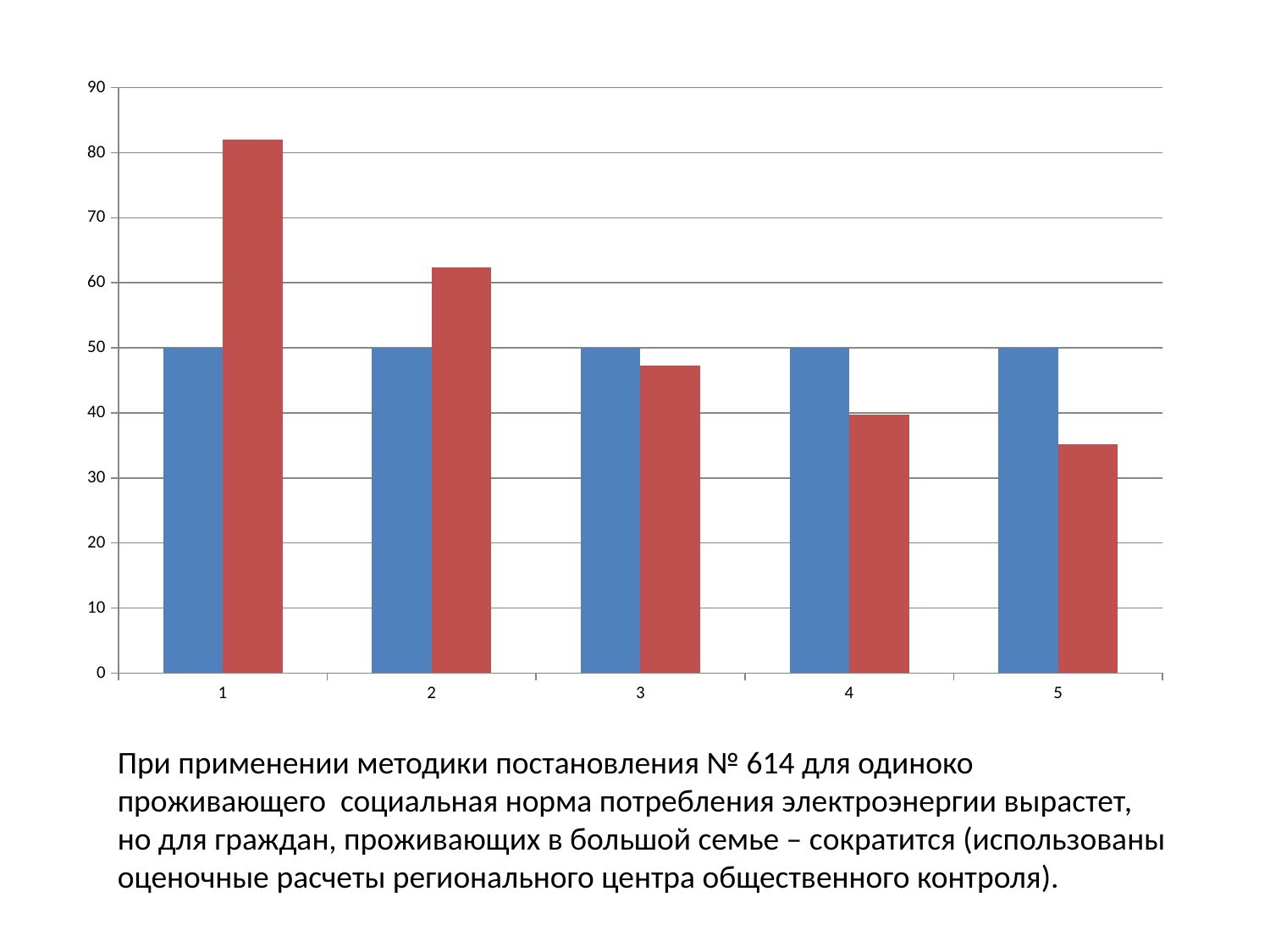
For category 1, which bar is taller, the blue one or the red one? the red one What kind of chart is shown on the slide? bar chart Do the red bars rise or fall from category 1 to category 5? fall Among the red bars, which category has the highest value? 1 Is the value of the red bar for category 1 greater or less than 70? greater Is the value of the red bar for category 3 greater or less than 50? less For category 5, which bar is taller, the blue one or the red one? the blue one What is the value of the blue bar for category 1? 50 How many categories are shown on the x axis of the chart? 5 Is the value of the red bar for category 5 greater or less than 40? less What is the value of the blue bar for category 4? 50